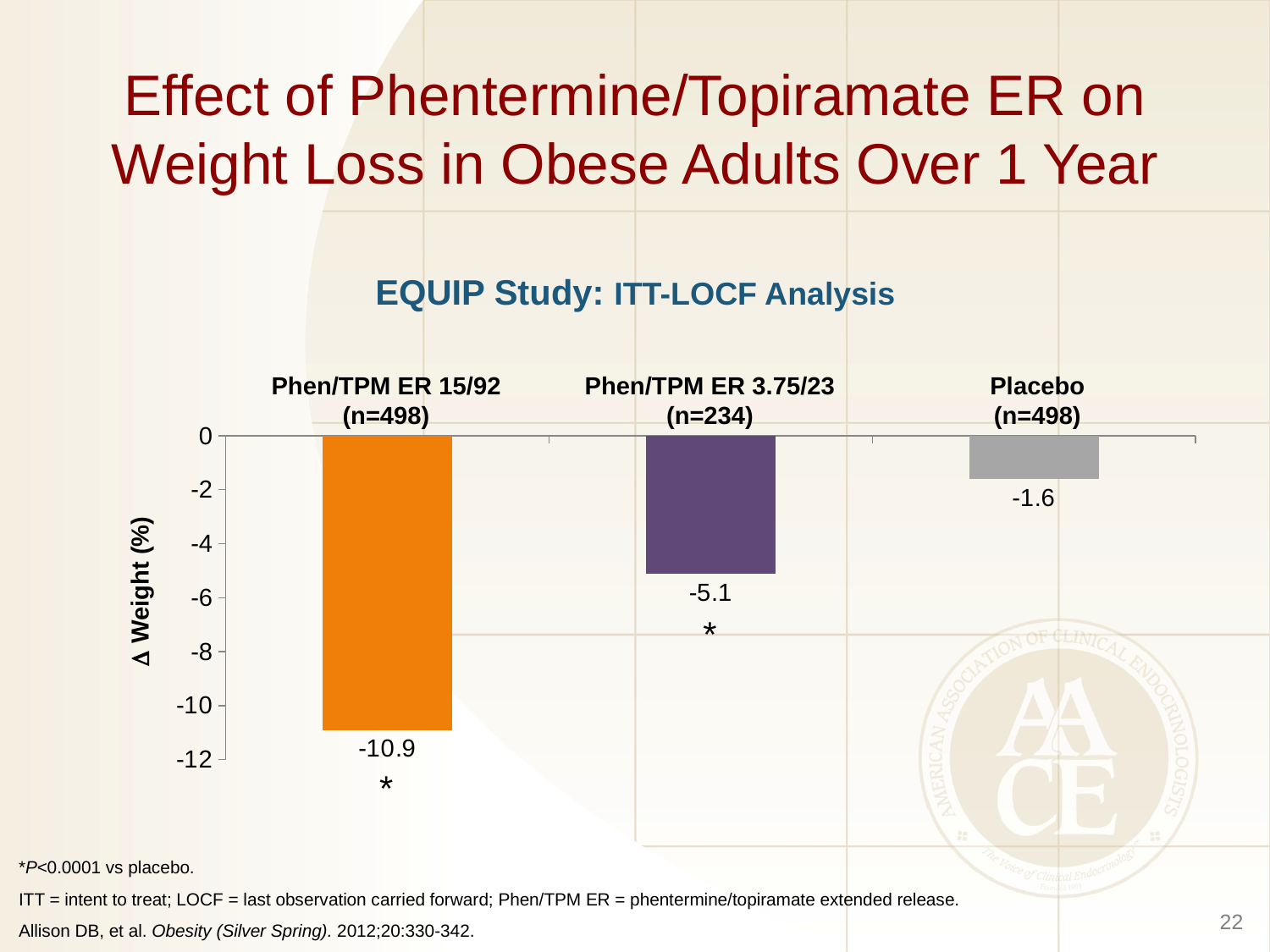
What type of chart is shown on the slide? Bar chart What is the sample size (n) for the Phen/TPM ER 3.75/23 group? 234 Which group shows the smallest weight loss? Placebo How many treatment groups are shown in the chart? 3 What is the change in weight (%) for Phen/TPM ER 3.75/23? -5.1 Which group shows the largest weight loss? Phen/TPM ER 15/92 Which group lost more weight, Phen/TPM ER 3.75/23 or Placebo? Phen/TPM ER 3.75/23 What is the change in weight (%) for Placebo? -1.6 What is the difference in weight change between Phen/TPM ER 3.75/23 and Placebo? 3.5 What is the label of the y axis? Δ Weight (%) What is the change in weight (%) for Phen/TPM ER 15/92? -10.9 What is the difference in weight change between Phen/TPM ER 15/92 and Placebo? 9.3